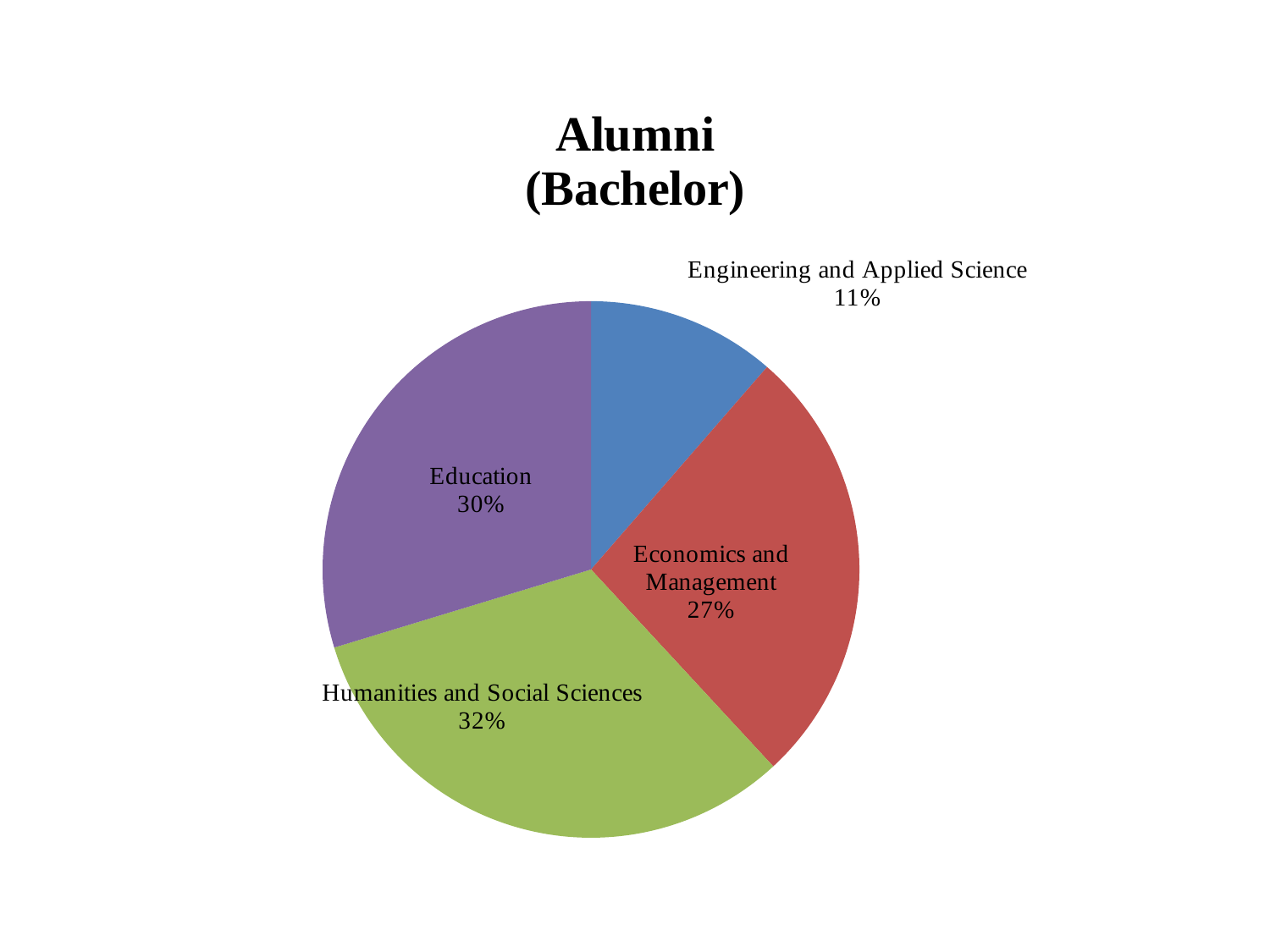
Which is larger, the share for Education or the share for Economics and Management? Education What colour is the Education slice? purple What share of the pie does Engineering and Applied Science represent? 11% What is the difference in percentage points between Humanities and Social Sciences and Engineering and Applied Science? 21 What share of the pie does Humanities and Social Sciences represent? 32% How many categories are shown in the pie chart? 4 What share of the pie does Education represent? 30% Which category has the smallest share of the pie? Engineering and Applied Science Which category has the largest share of the pie? Humanities and Social Sciences What is the title of the chart? Alumni (Bachelor) What kind of chart is shown on the slide? pie chart